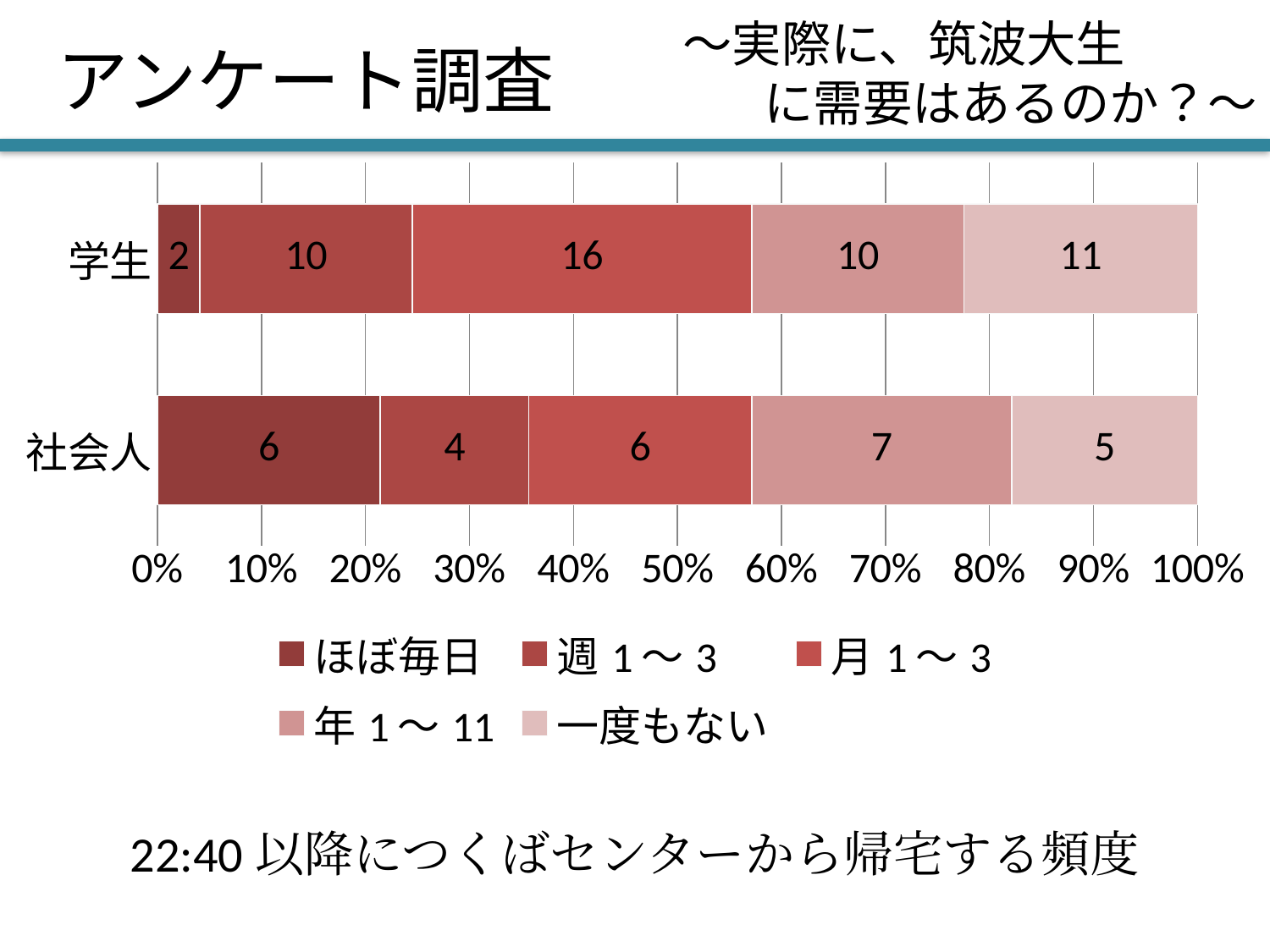
What is the value for 月1〜3 in the 学生 bar? 16 What is the value for 一度もない in the 学生 bar? 11 What is the value for 年1〜11 in the 社会人 bar? 7 What kind of chart is shown on the slide? Stacked bar chart What is the total of all segments in the 社会人 bar? 28 Which is larger: the ほぼ毎日 value for 学生 or for 社会人? 社会人 Which series has the smallest value in the 学生 bar? ほぼ毎日 How many series does the legend list? 5 What is the value for ほぼ毎日 in the 社会人 bar? 6 What is the total of all segments in the 学生 bar? 49 Which series has the largest value in the 学生 bar? 月1〜3 What is the difference between the 月1〜3 values for 学生 and 社会人? 10